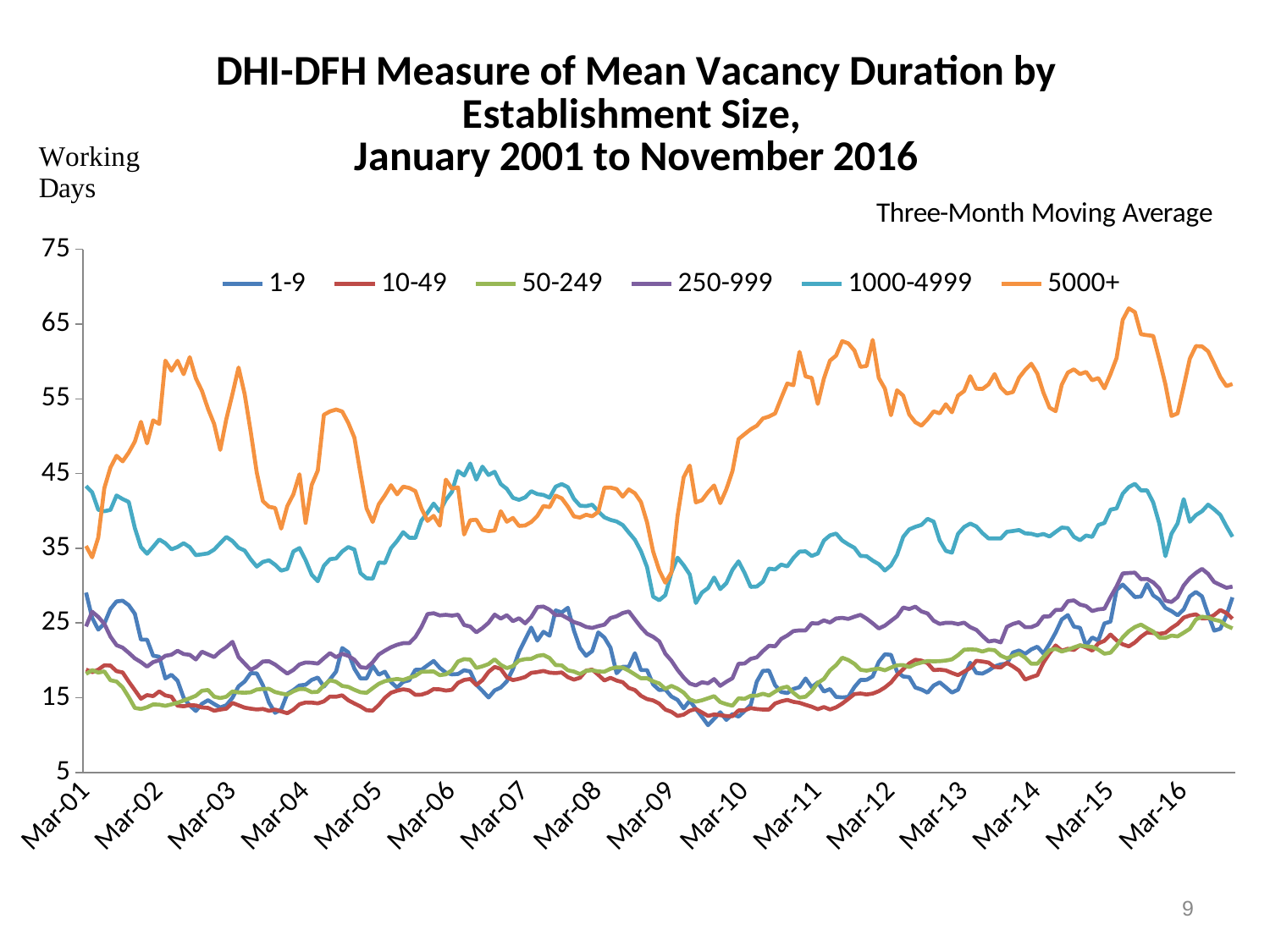
How many year labels are shown on the x axis? 16 What are the establishment size categories listed in the legend? 1-9, 10-49, 50-249, 250-999, 1000-4999, 5000+ Is the value for the 5000+ series at Mar-15 greater or less than 45? greater Does the 5000+ series rise or fall between Mar-09 and Mar-11? rise How many series does the legend list? 6 Which establishment size series has the highest vacancy duration across the whole period? 5000+ What unit is shown on the vertical axis label? Working Days What kind of chart is shown on the slide? line chart Is the value for the 250-999 series at Mar-15 greater or less than 20? greater At Mar-12, which series has the larger value, 5000+ or 1000-4999? 5000+ Is the value for the 1000-4999 series at Mar-09 greater or less than 35? less At Mar-05, which series has the larger value, 1000-4999 or 250-999? 1000-4999